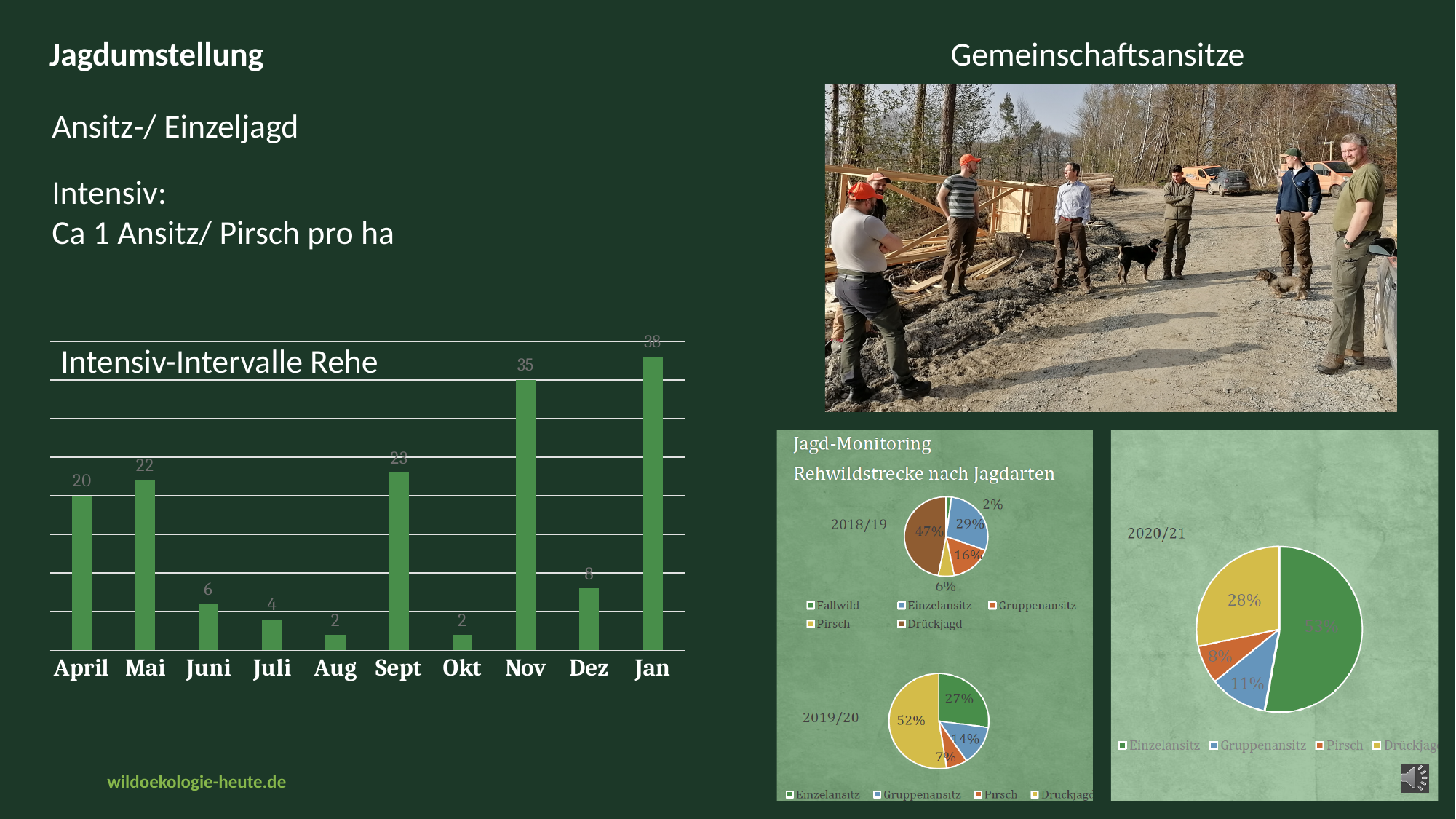
In the 'Intensiv-Intervalle Rehe' bar chart, what is the value for Nov? 35 How many entries does the legend of the 2018/19 pie chart list? 5 In the 'Intensiv-Intervalle Rehe' bar chart, what is the difference between the values for Dez and Okt? 6 What kind of chart is 'Intensiv-Intervalle Rehe'? bar chart How many months are shown on the x axis of the 'Intensiv-Intervalle Rehe' bar chart? 10 In the 'Intensiv-Intervalle Rehe' bar chart, what is the difference between the values for Jan and Nov? 3 In the 2020/21 pie chart on the right, what share does Drückjagd have? 28% In the 'Intensiv-Intervalle Rehe' bar chart, what is the value for Sept? 23 In the 2018/19 pie chart under 'Jagd-Monitoring Rehwildstrecke nach Jagdarten', what share does Drückjagd have? 47% In the 'Intensiv-Intervalle Rehe' bar chart, which is larger, the value for Mai or the value for April? Mai In the 'Intensiv-Intervalle Rehe' bar chart, which month has the highest value? Jan In the 2019/20 pie chart under 'Jagd-Monitoring Rehwildstrecke nach Jagdarten', what share does Einzelansitz have? 27%